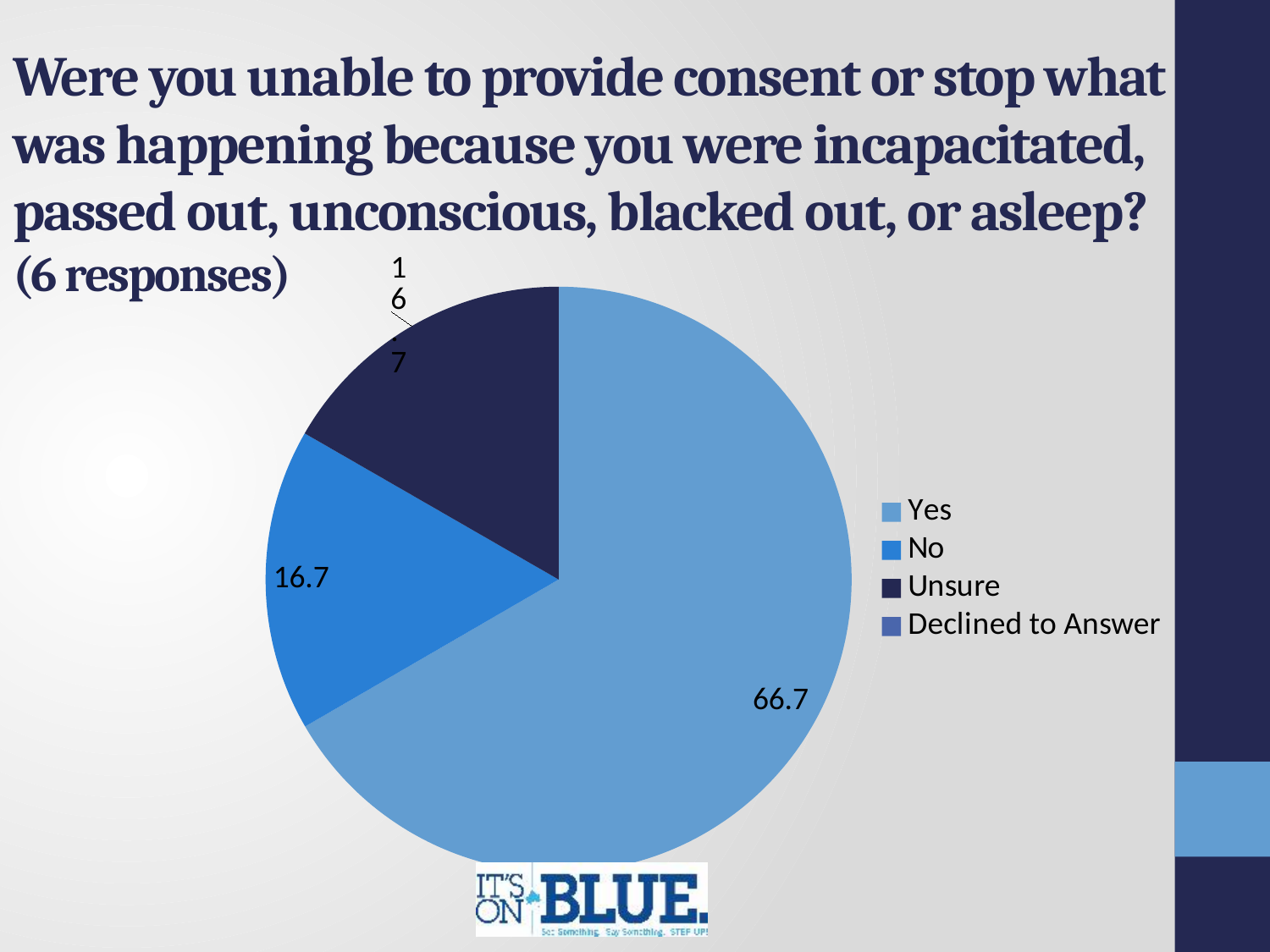
Which response category has the largest slice of the pie? Yes What value is shown for the "No" slice? 16.7 Which legend entry is shown in the darkest navy colour? Unsure What percentage of responses were "Yes"? 66.7 How many responses does the slide say the chart is based on? 6 responses What value is shown for the "Unsure" slice? 16.7 What kind of chart is shown on the slide? Pie chart How many entries does the legend list? 4 Is the value for "Yes" greater or less than 50? greater What is the combined value of the "No" and "Unsure" slices? 33.4 Which is larger, the "Yes" slice or the "No" slice? Yes What is the difference between the "Yes" value and the "No" value? 50